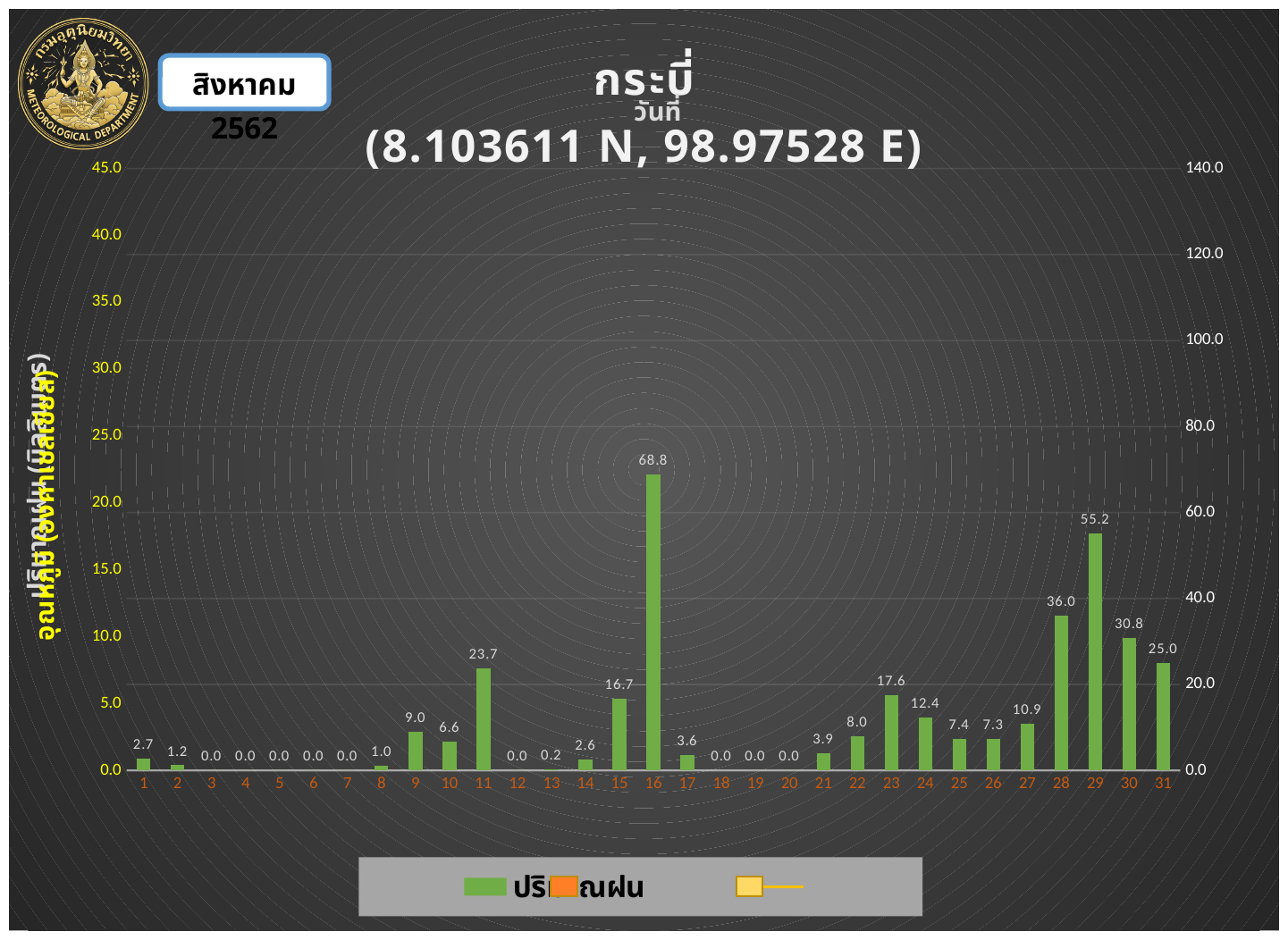
What coordinates are given in the chart title? 8.103611 N, 98.97528 E What is the value for day 16? 68.8 What is the difference between the values for day 30 and day 31? 5.8 Which day has the highest value? 16 How many days are shown on the x axis? 31 What is the value for day 29? 55.2 What is the difference between the values for day 29 and day 28? 19.2 What is the value for day 11? 23.7 What kind of chart is shown on the slide? bar chart Which is larger, the value for day 15 or the value for day 24? day 15 Is the value for day 16 greater or less than 60.0 on the right axis? greater What is the value for day 23? 17.6